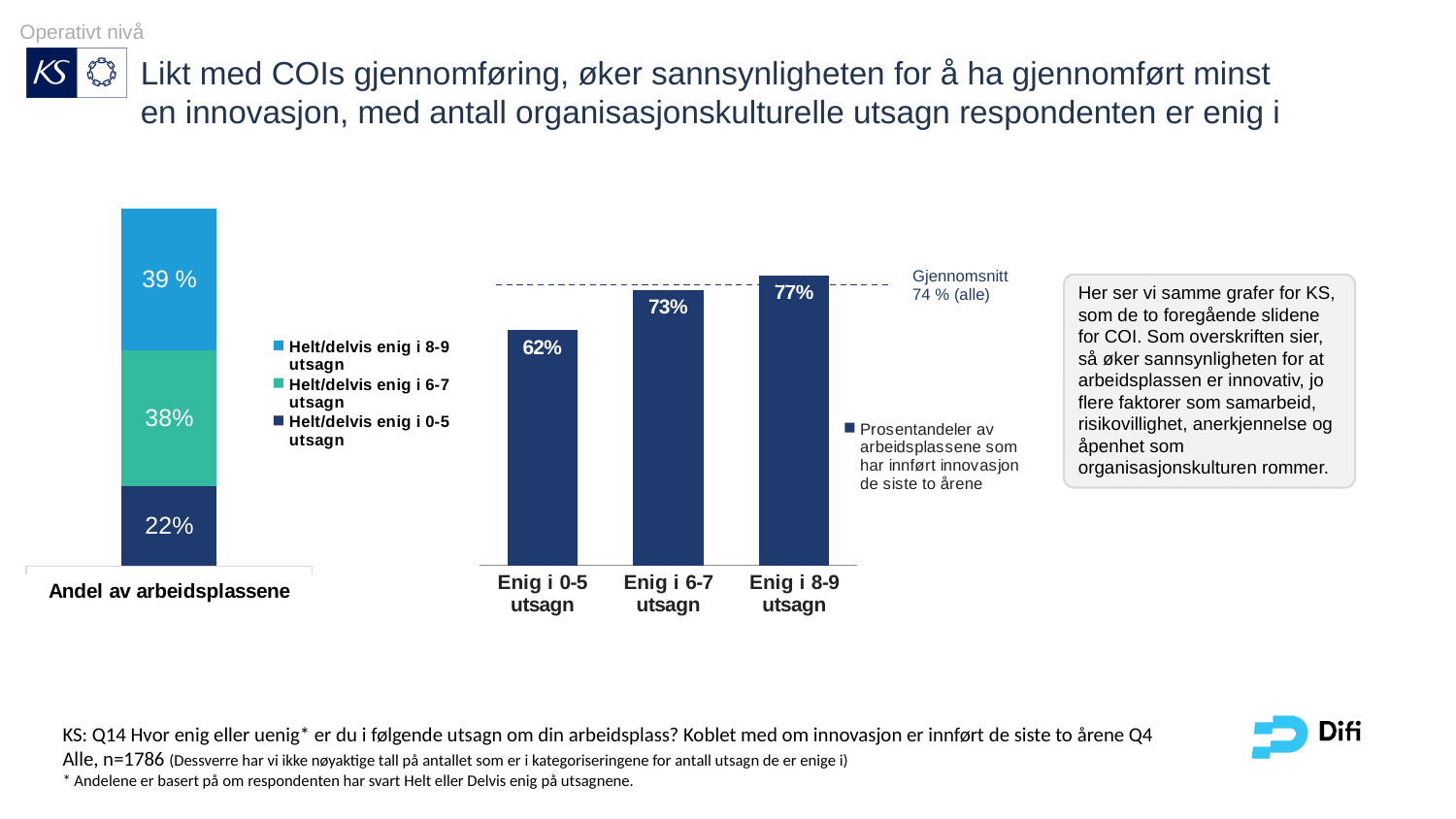
In the right-hand bar chart, how many bars are plotted? 3 In the right-hand bar chart, which category has the highest value? Enig i 8-9 utsagn What type of chart is the left-hand chart 'Andel av arbeidsplassene'? stacked bar chart In the right-hand bar chart, do the values rise or fall from 'Enig i 0-5 utsagn' to 'Enig i 8-9 utsagn'? rise In the left-hand chart 'Andel av arbeidsplassene', what is the value of the 'Helt/delvis enig i 8-9 utsagn' segment? 39 % In the right-hand bar chart, what is the value for 'Enig i 6-7 utsagn'? 73% In the right-hand bar chart, what average value does the dashed 'Gjennomsnitt' line indicate? 74 % (alle) In the left-hand chart 'Andel av arbeidsplassene', what is the value of the 'Helt/delvis enig i 0-5 utsagn' segment? 22% In the right-hand bar chart, what is the difference between the values for 'Enig i 8-9 utsagn' and 'Enig i 0-5 utsagn'? 15 percentage points In the left-hand chart 'Andel av arbeidsplassene', how many series does the legend list? 3 In the right-hand bar chart, which category has the lowest value? Enig i 0-5 utsagn In the right-hand bar chart, what is the value for 'Enig i 0-5 utsagn'? 62%